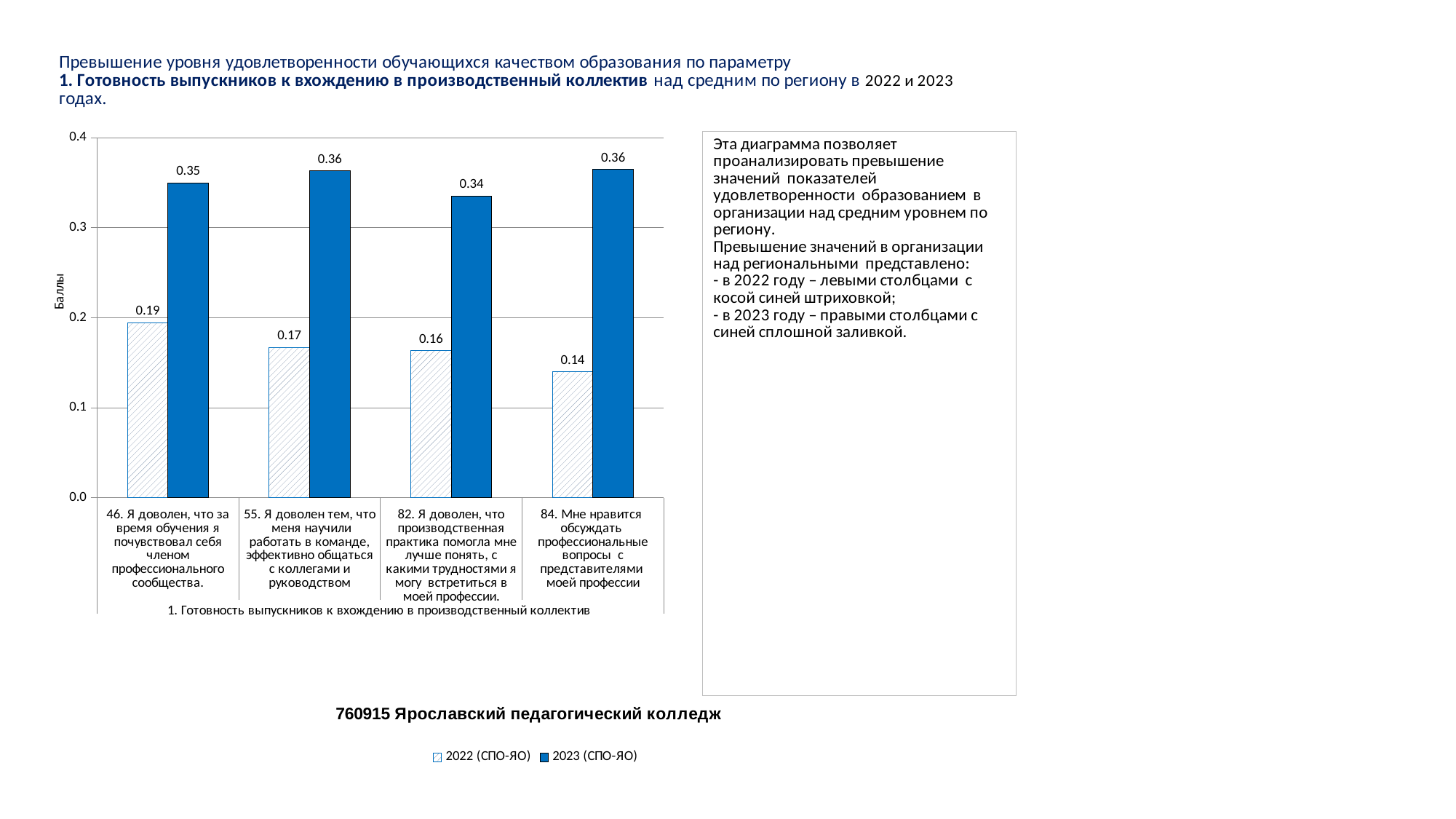
Which category has the highest value for the 2022 (СПО-ЯО) series? 46. Я доволен, что за время обучения я почувствовал себя членом профессионального сообщества. Which is larger for category 55: the 2022 (СПО-ЯО) value or the 2023 (СПО-ЯО) value? 2023 (СПО-ЯО) What kind of chart is shown on the slide? Bar chart How many categories are shown on the x axis of the chart? 4 What is the value for 2022 (СПО-ЯО) for category 46 (Я доволен, что за время обучения я почувствовал себя членом профессионального сообщества)? 0.19 What is the value for 2023 (СПО-ЯО) for category 55 (Я доволен тем, что меня научили работать в команде...)? 0.36 What is the difference between the 2023 (СПО-ЯО) and 2022 (СПО-ЯО) values for category 46? 0.16 What is the value for 2023 (СПО-ЯО) for category 82 (Я доволен, что производственная практика помогла мне лучше понять...)? 0.34 How many series does the legend list? 2 What is the difference between the 2023 (СПО-ЯО) and 2022 (СПО-ЯО) values for category 84? 0.22 Which category has the lowest value for the 2022 (СПО-ЯО) series? 84. Мне нравится обсуждать профессиональные вопросы с представителями моей профессии Do the values of the 2022 (СПО-ЯО) series rise or fall from left to right along the x axis? Fall